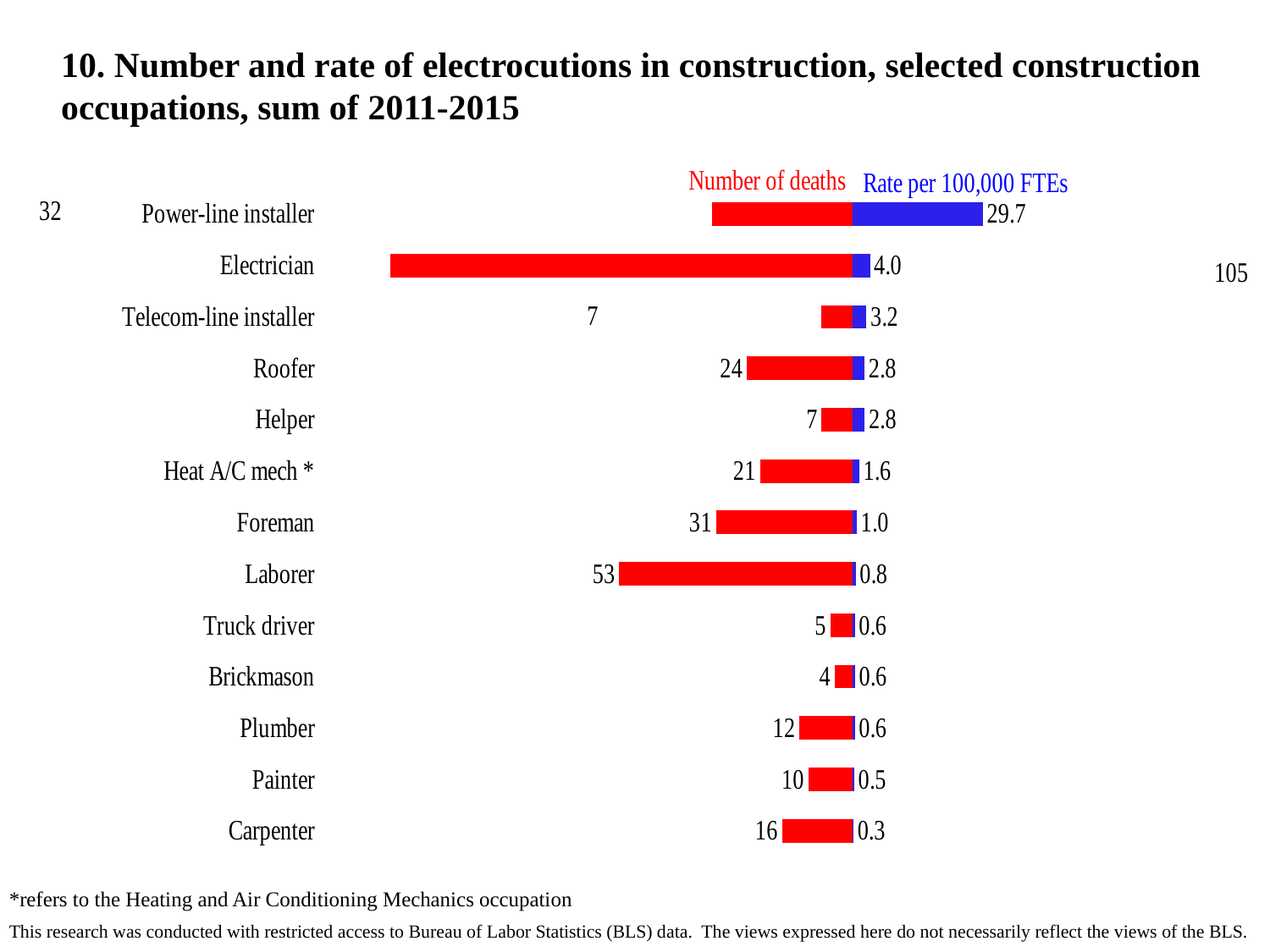
What is the number of deaths for Laborer? 53 Which occupation has the highest number of deaths? Electrician Which occupation has the highest rate per 100,000 FTEs? Power-line installer What type of chart is shown on the slide? Bar chart What is the number of deaths for Electrician? 105 Which has more deaths, Foreman or Roofer? Foreman Which occupation has the lowest number of deaths? Brickmason How many occupations are shown in the chart? 13 What is the rate per 100,000 FTEs for Carpenter? 0.3 What is the difference in number of deaths between Electrician and Laborer? 52 How many data series does the chart show? 2 What is the rate per 100,000 FTEs for Power-line installer? 29.7